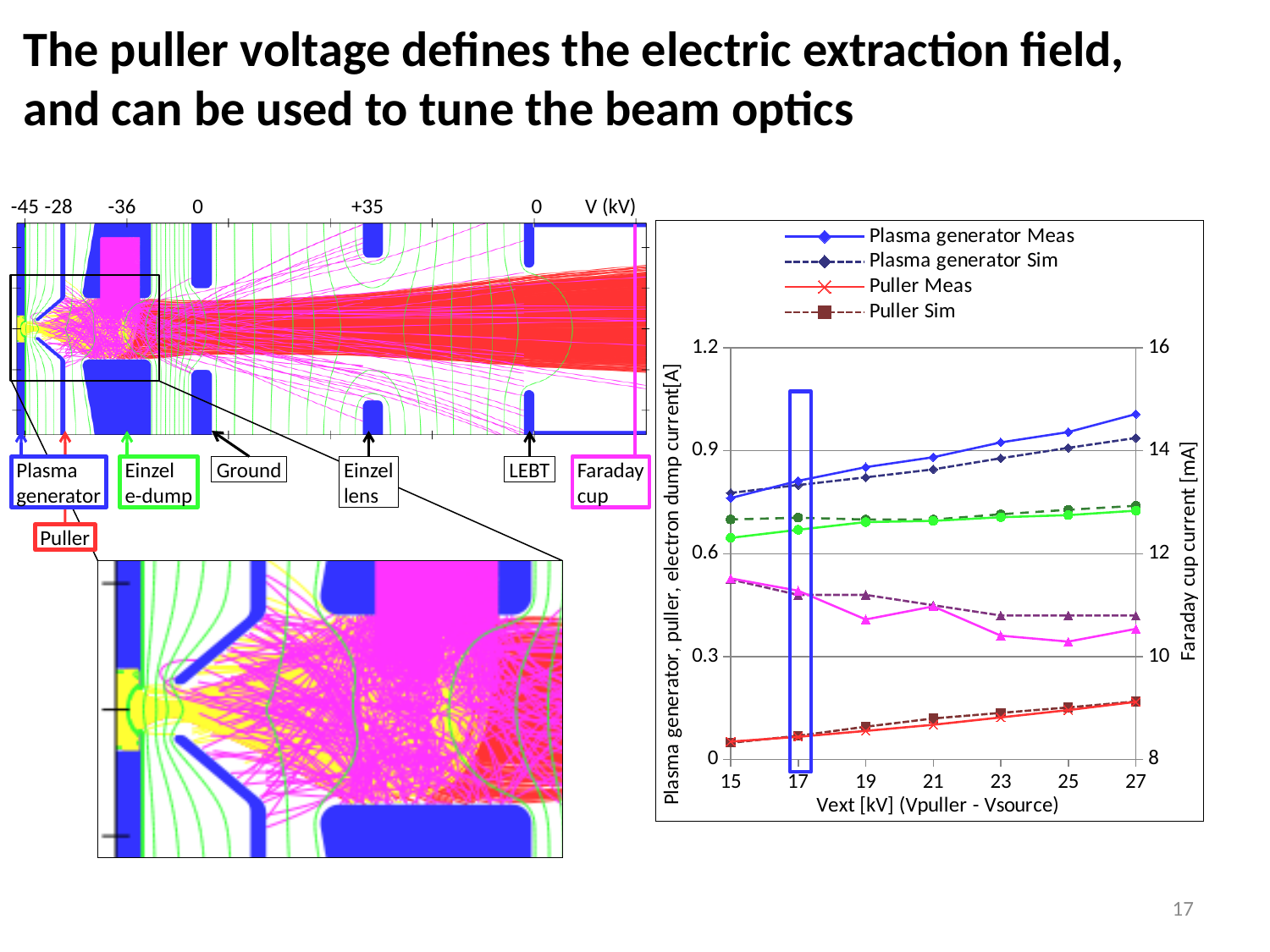
What is the title of the x axis of the chart? Vext [kV] (Vpuller - Vsource) Does the Puller Meas series rise or fall as Vext increases along the x axis? rise What kind of chart is shown on the right side of the slide? line chart Is the Plasma generator Meas value at Vext = 27 kV greater or less than 0.9 on the left axis? greater Is the Plasma generator Meas value at Vext = 15 kV greater or less than 0.9 on the left axis? less Is the Puller Sim value at Vext = 15 kV greater or less than 0.3 on the left axis? less Which legend series has the highest value at Vext = 27 kV? Plasma generator Meas How many series does the legend of the chart list? 4 Does the Plasma generator Meas series rise or fall as Vext increases from 15 to 27 kV? rise How many Vext values are marked along the x axis of the chart? 7 At Vext = 27 kV, which is larger: the Plasma generator Meas value or the Puller Meas value? Plasma generator Meas